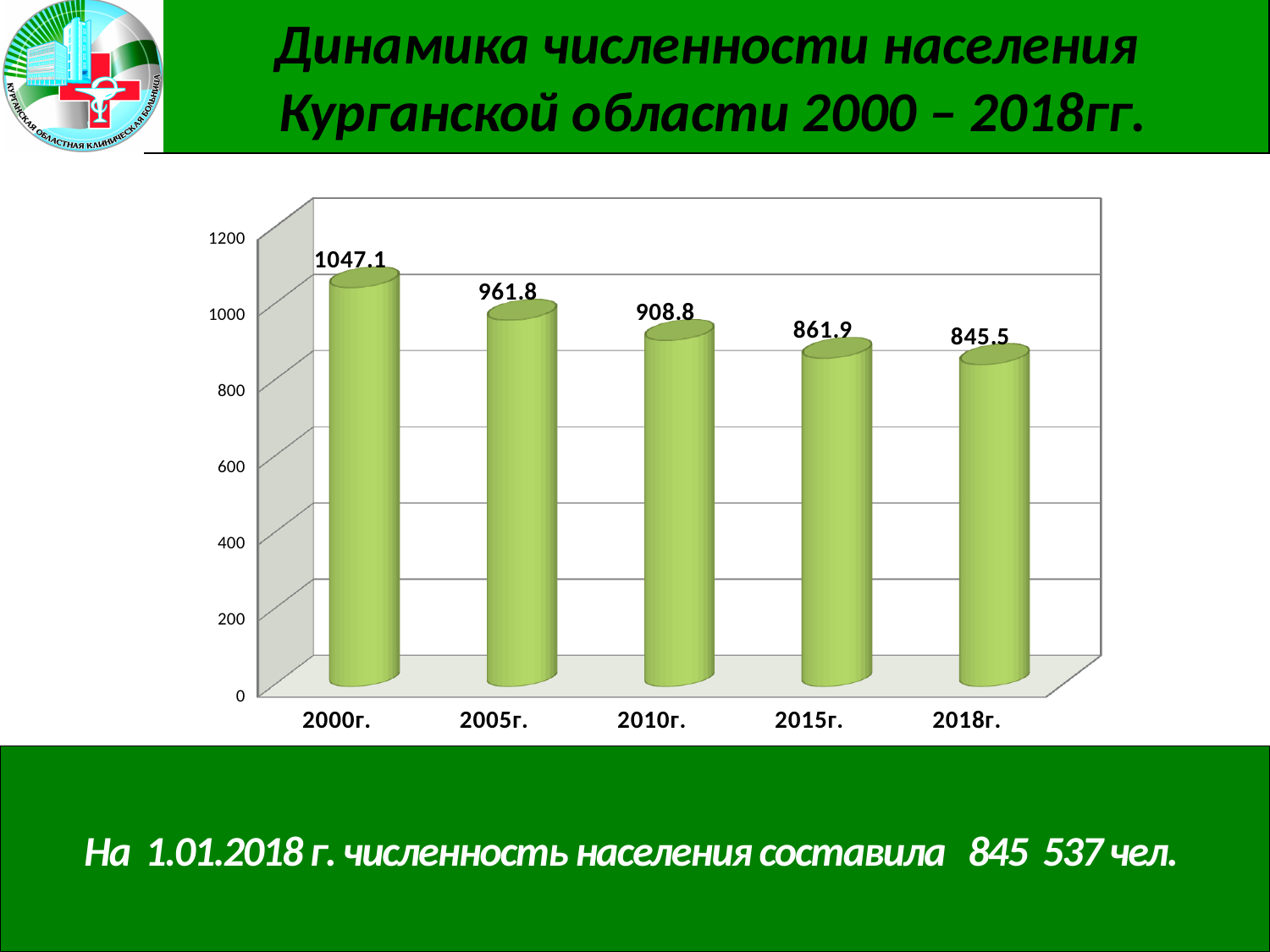
What is the value for 2000г.? 1047.1 What is the difference between the values for 2000г. and 2018г.? 201.6 What is the value for 2010г.? 908.8 Which year has the highest value? 2000г. How many years are shown on the x axis? 5 What is the difference between the values for 2005г. and 2010г.? 53 Which year has the lowest value? 2018г. Is the value for 2015г. greater or less than 1000? less What kind of chart is shown on the slide? bar chart Do the values rise or fall from 2000г. to 2018г.? fall Which is larger, the value for 2005г. or the value for 2015г.? 2005г. What is the value for 2018г.? 845.5